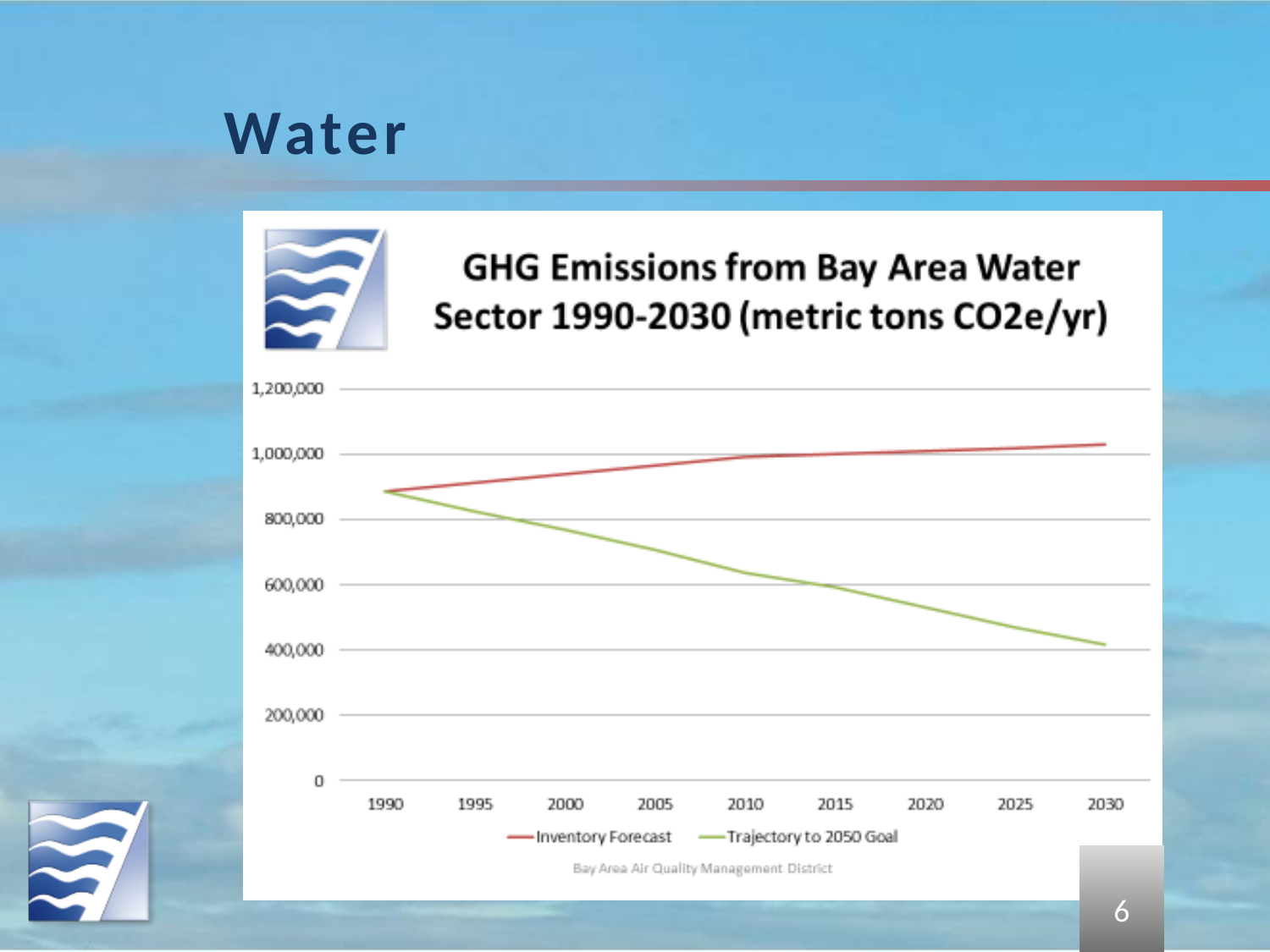
Is the Trajectory to 2050 Goal value in 2030 greater or less than 600,000? less Does the Inventory Forecast line rise or fall from 1990 to 2030? rise Is the Inventory Forecast value in 1990 greater or less than 800,000? greater How many year labels are shown on the x axis? 9 What kind of chart is shown on the slide? line chart How many series does the legend list? 2 Does the Trajectory to 2050 Goal line rise or fall from 1990 to 2030? fall Is the Inventory Forecast value in 2030 greater or less than 800,000? greater In 2030, which series has the higher value, Inventory Forecast or Trajectory to 2050 Goal? Inventory Forecast Which series is drawn in green? Trajectory to 2050 Goal What is the title of the chart? GHG Emissions from Bay Area Water Sector 1990-2030 (metric tons CO2e/yr)